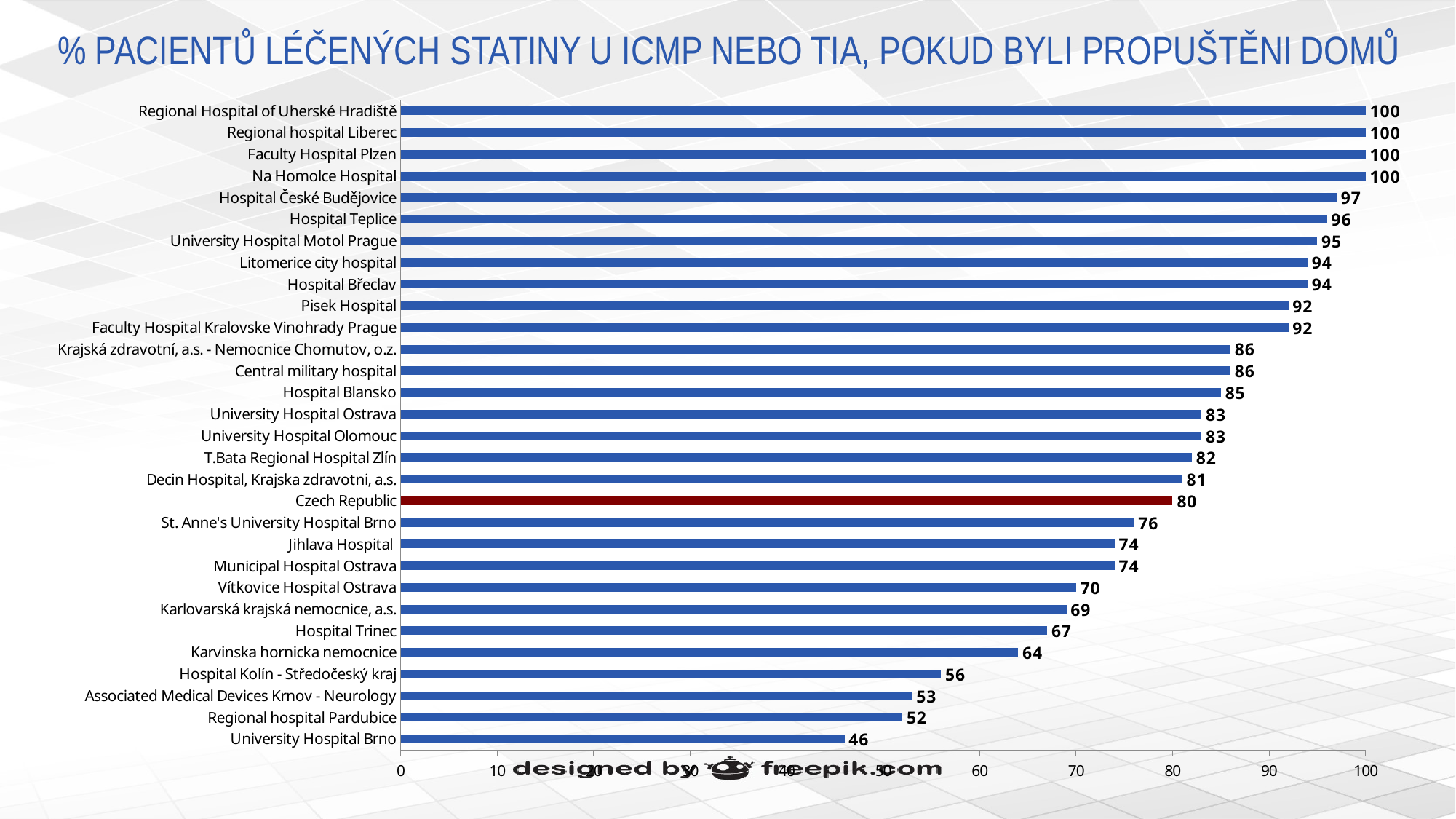
What is the value for Hospital Teplice? 96 What is the value for Karvinska hornicka nemocnice? 64 What kind of chart is shown on the slide? bar chart What is the difference between the values for Hospital České Budějovice and Hospital Trinec? 30 How many categories are shown in the chart? 30 Which category's bar is shown in a different colour (dark red) from the others? Czech Republic Which category has the lowest value? University Hospital Brno What is the value for Czech Republic? 80 Which is larger, the value for Jihlava Hospital or the value for Hospital Kolín - Středočeský kraj? Jihlava Hospital What is the difference between the values for Czech Republic and University Hospital Brno? 34 Is the value for Regional hospital Pardubice greater or less than 60? less What is the value for University Hospital Brno? 46